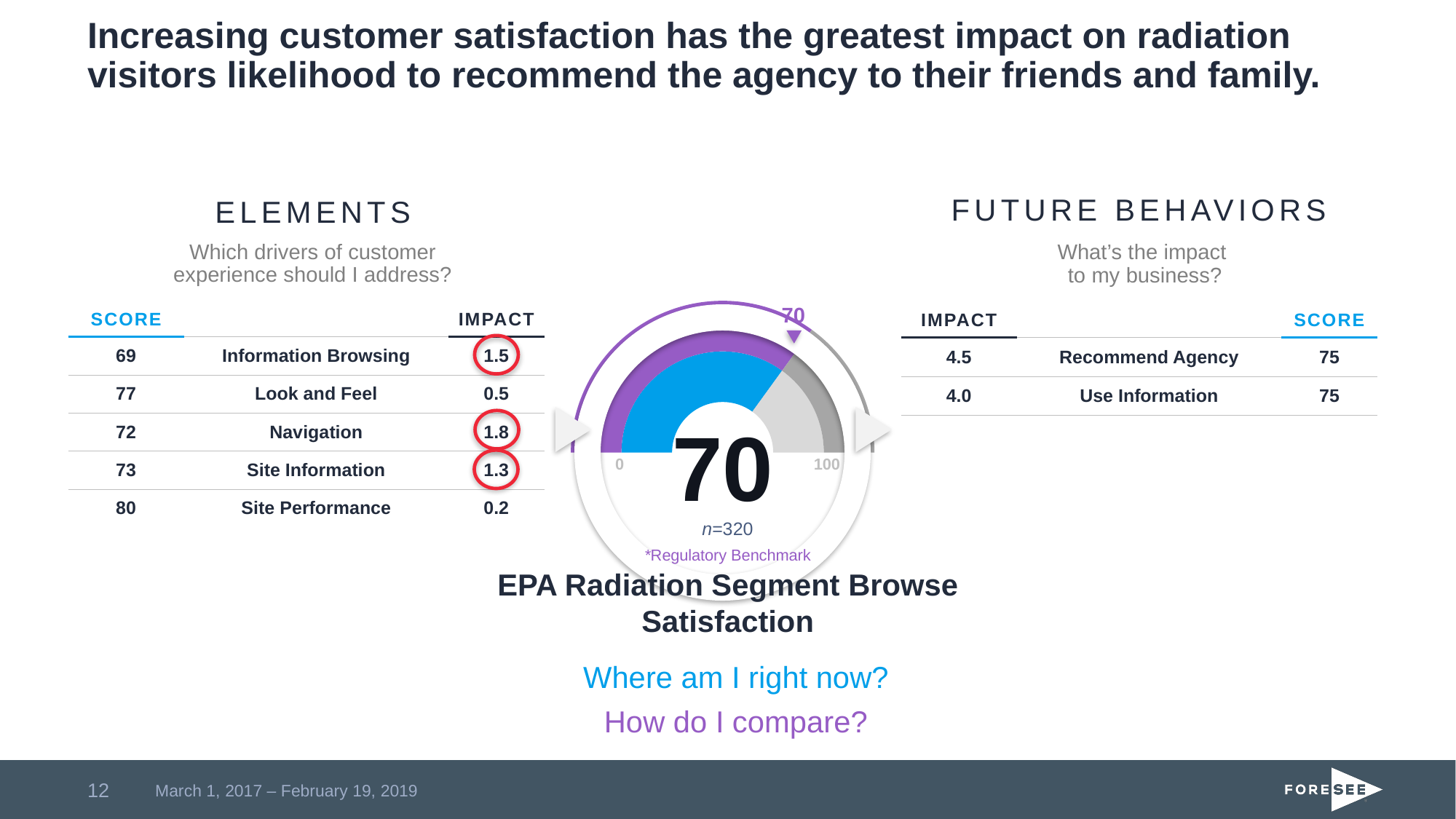
What is the title of the gauge chart? EPA Radiation Segment Browse Satisfaction In the Elements table, which element has the highest score? Site Performance What is the difference between the gauge score and the Regulatory Benchmark? 0 What are the minimum and maximum values labeled on the gauge scale? 0 and 100 How many elements are listed in the Elements table? 5 Is the satisfaction score on the gauge greater or less than 50? greater What is the Regulatory Benchmark value marked on the gauge? 70 In the Future Behaviors table, what is the impact of Recommend Agency? 4.5 What is the sample size (n) shown under the satisfaction gauge? n=320 In the Elements table, which element has the highest impact? Navigation What value does the EPA Radiation Segment Browse Satisfaction gauge show? 70 What kind of chart is used to display the EPA Radiation Segment Browse Satisfaction score? gauge chart